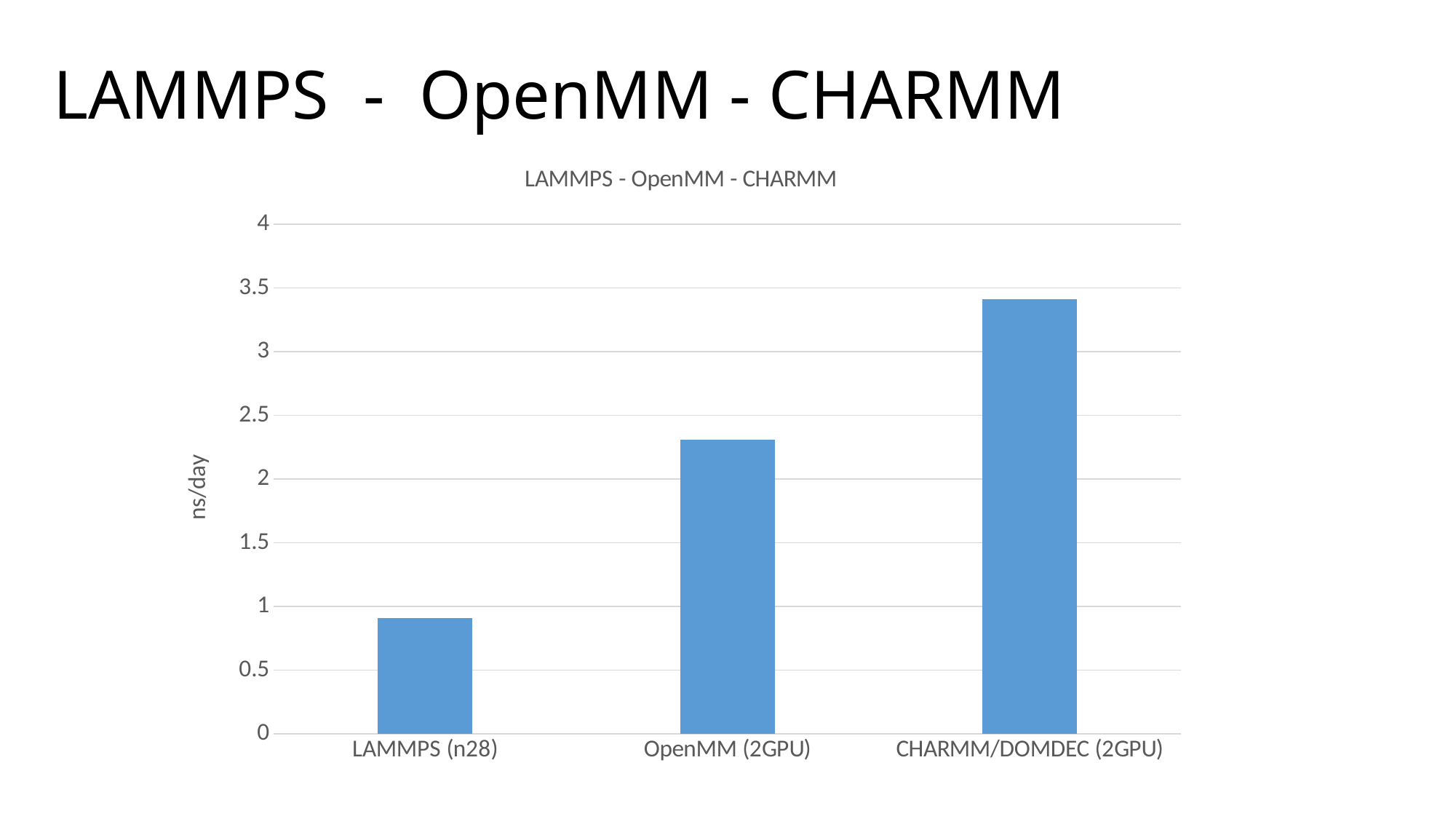
Is the value for CHARMM/DOMDEC (2GPU) greater or less than 3? greater Which category has the lowest value? LAMMPS (n28) Is the value for LAMMPS (n28) greater or less than 1? less Is the value for CHARMM/DOMDEC (2GPU) greater or less than 3.5? less How many categories are plotted in the chart? 3 What type of chart is shown on the slide? bar chart What is the title of the chart? LAMMPS - OpenMM - CHARMM Do the values rise or fall from left to right across the categories? rise Which category has the highest value? CHARMM/DOMDEC (2GPU) Which is larger, the value for OpenMM (2GPU) or the value for LAMMPS (n28)? OpenMM (2GPU) What is the label of the vertical axis? ns/day